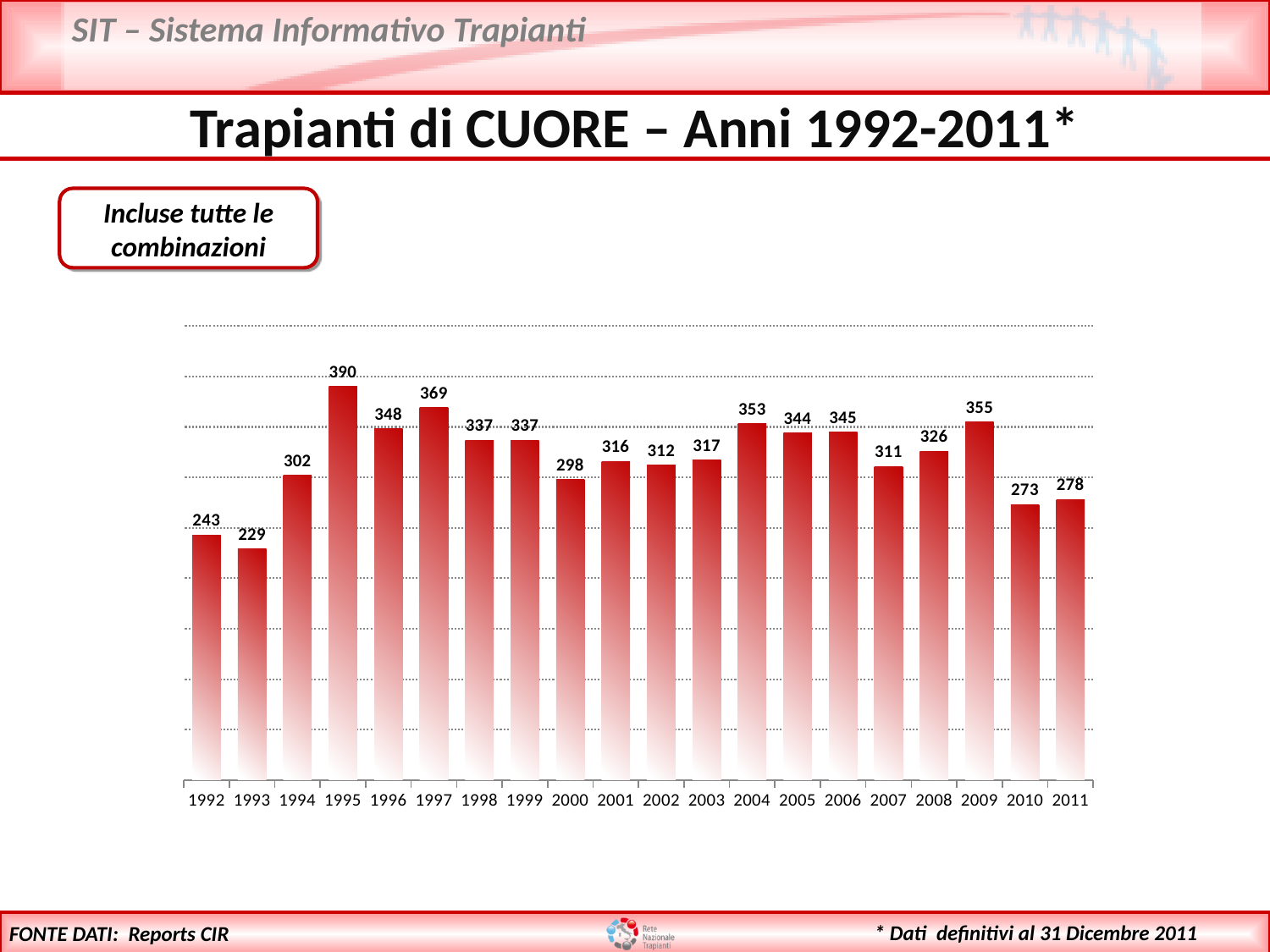
How many years are shown on the x axis? 20 What is the title of the slide containing the chart? Trapianti di CUORE – Anni 1992-2011* Which year has the lowest value? 1993 What is the difference between the values for 2009 and 2010? 82 Which year has the highest value? 1995 Which is larger, the value for 1997 or the value for 2009? 1997 Do the values rise or fall from 2009 to 2010? fall What is the value for 2011? 278 What is the value for 1995? 390 What is the difference between the values for 1995 and 1993? 161 What kind of chart is this? bar chart What is the value for 2004? 353